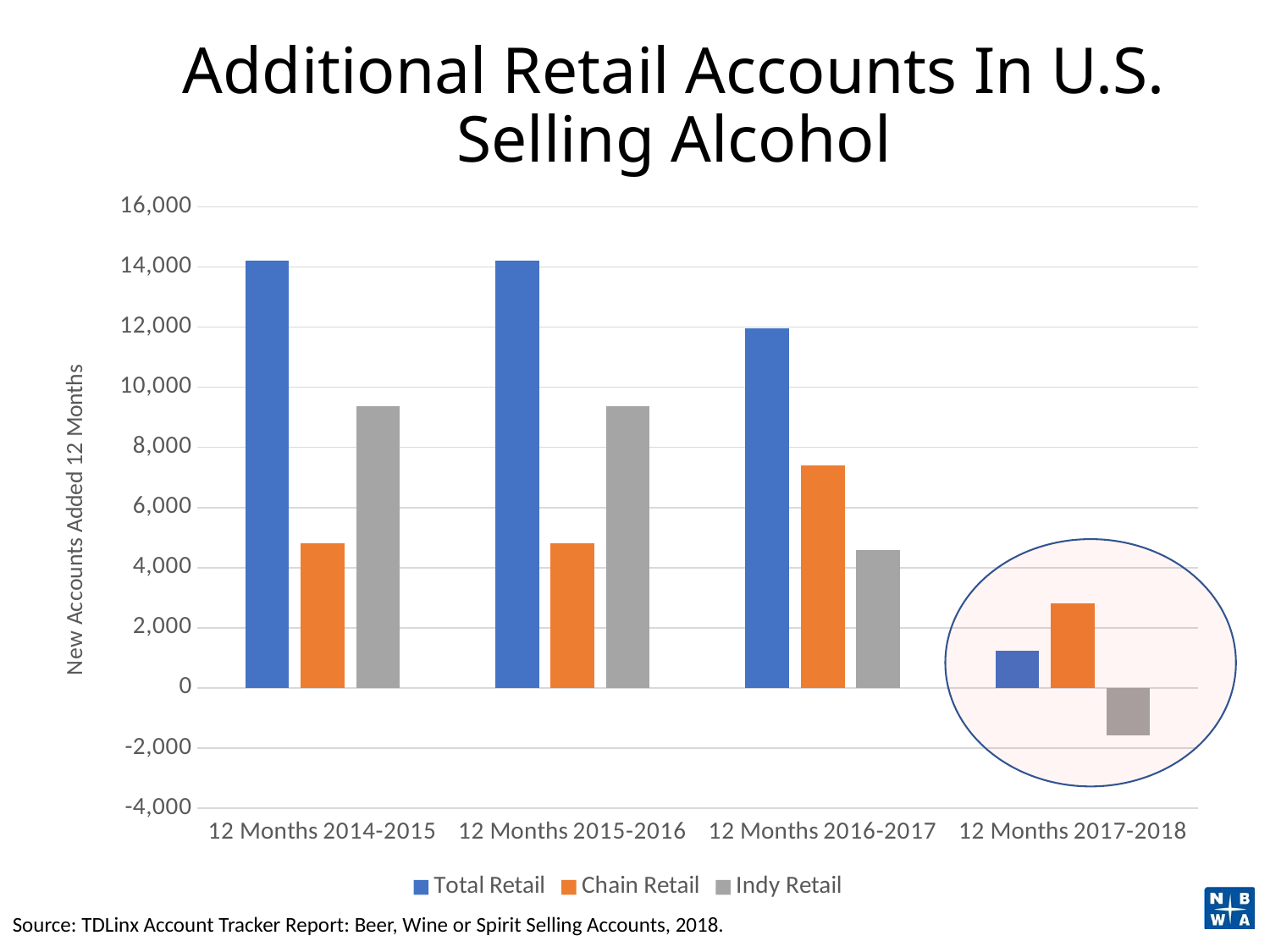
Which is larger for 12 Months 2014-2015, Chain Retail or Indy Retail? Indy Retail Is the Chain Retail value for 12 Months 2016-2017 greater or less than 8,000? less Which time period has the lowest Total Retail value? 12 Months 2017-2018 How many time periods are shown on the x axis? 4 Which is larger for 12 Months 2017-2018, Total Retail or Chain Retail? Chain Retail What is the title of the chart? Additional Retail Accounts In U.S. Selling Alcohol Is the Indy Retail value for 12 Months 2017-2018 greater or less than 0? less What kind of chart is shown on the slide? Bar chart How many series does the legend list? 3 Which time period has the highest Chain Retail value? 12 Months 2016-2017 Does the Indy Retail value rise or fall from 12 Months 2015-2016 to 12 Months 2017-2018? Fall